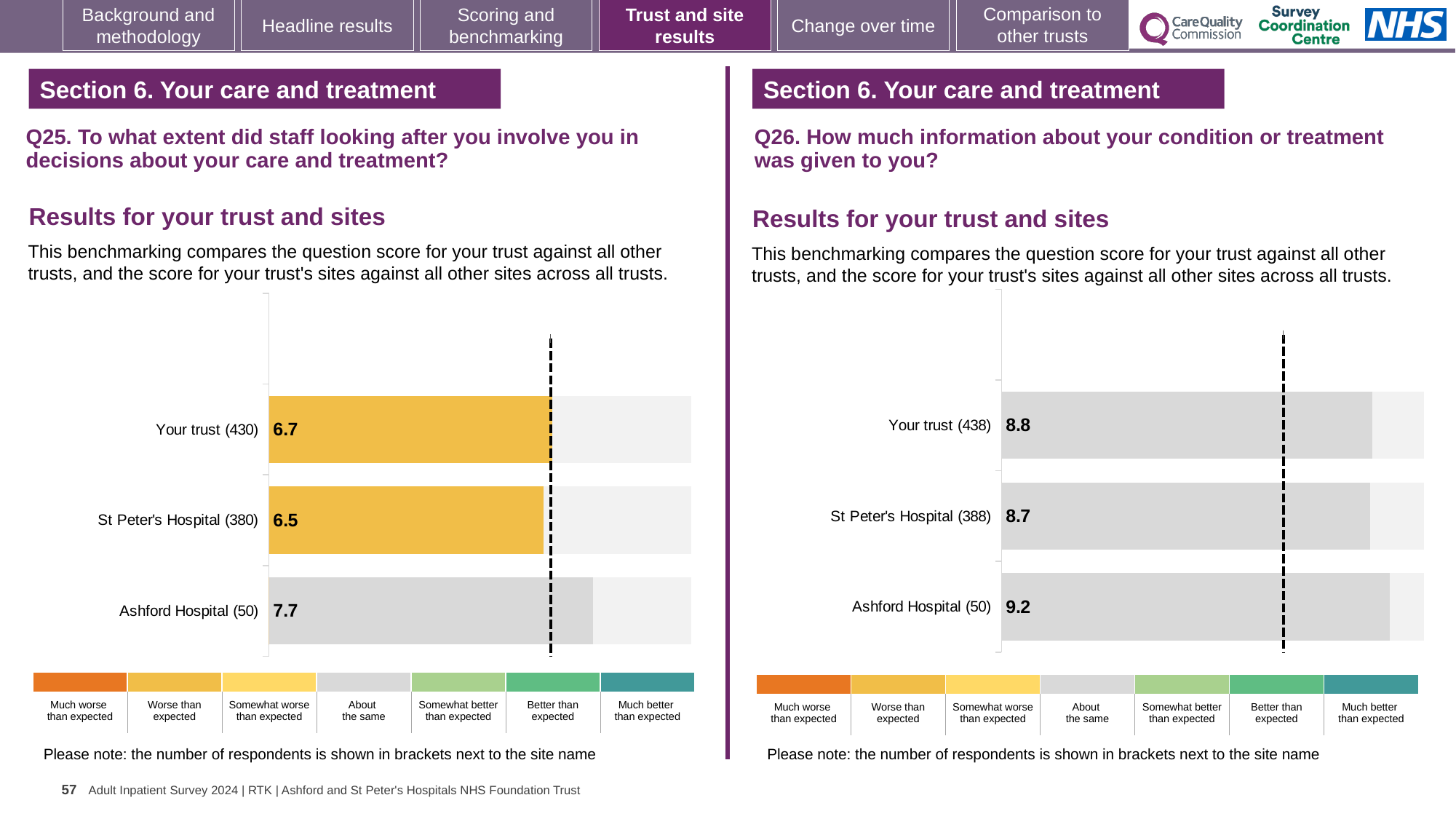
In the Q25 chart on the left, how many respondents are shown for Ashford Hospital? 50 In the Q26 chart on the right, how many bars are plotted? 3 In the Q26 chart on the right, what is the score for Your trust? 8.8 In the Q25 chart on the left, what is the difference between the scores for Ashford Hospital and St Peter's Hospital? 1.2 In the Q26 chart on the right, which site or trust has the lowest score? St Peter's Hospital In the Q25 chart on the left, what is the score for Your trust? 6.7 In the Q25 chart on the left, what is the score for St Peter's Hospital? 6.5 In the Q25 chart on the left, which benchmark category does the colour of the Your trust bar correspond to in the legend? Worse than expected In the Q26 chart on the right, what is the difference between the scores for Ashford Hospital and Your trust? 0.4 In the Q26 chart on the right, what is the score for Ashford Hospital? 9.2 What type of chart is used in the Q25 chart on the left? Bar chart In the Q25 chart on the left, which site or trust has the highest score? Ashford Hospital